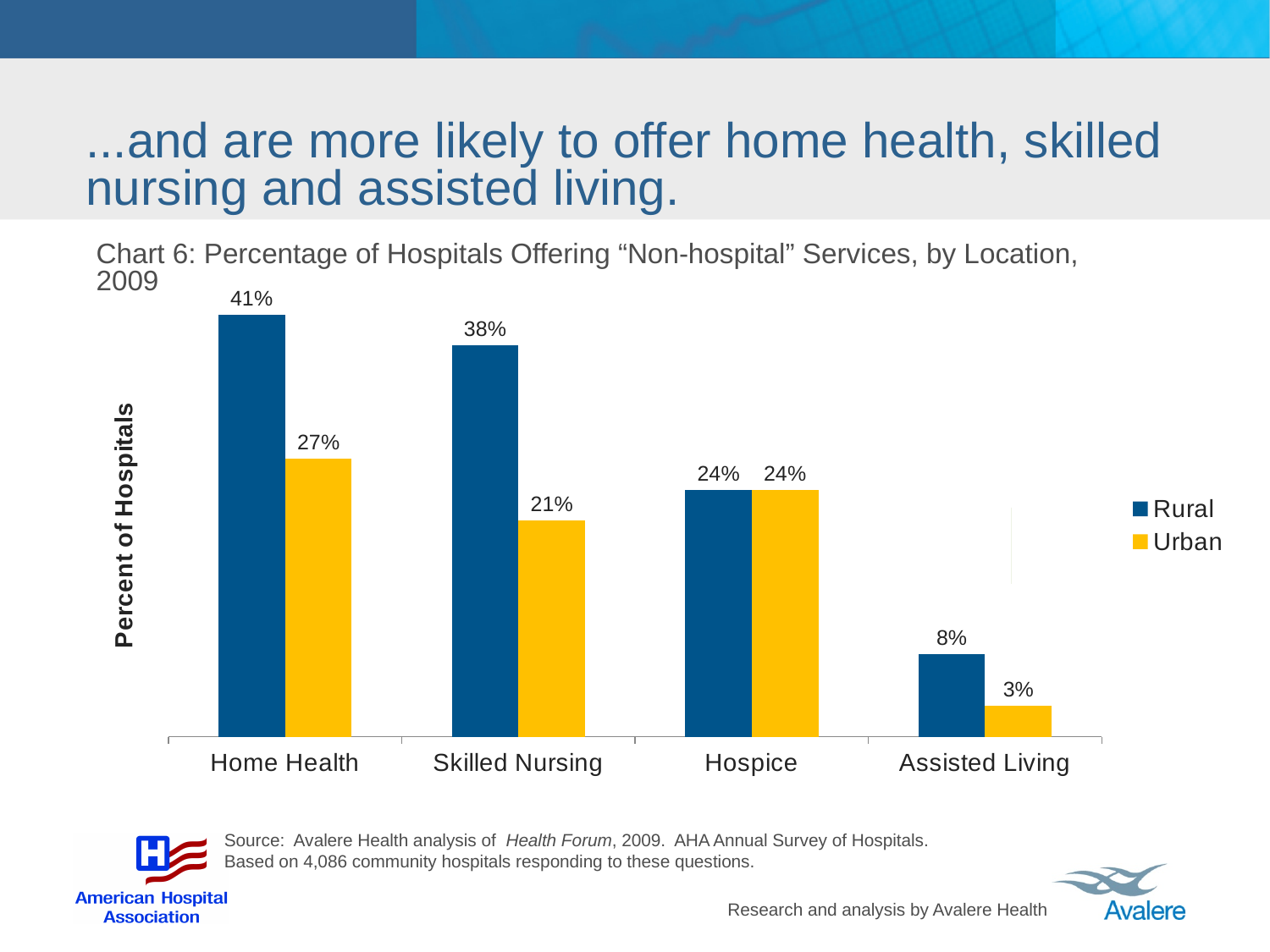
What percentage of urban hospitals offer skilled nursing services? 21% Which service category has the lowest value for urban hospitals? Assisted Living What kind of chart is shown on the slide? Bar chart What is the difference between the rural and urban percentages for home health? 14% What is the difference between the rural and urban percentages for skilled nursing? 17% What percentage of rural hospitals offer home health services? 41% What is the label on the vertical axis of the chart? Percent of Hospitals How many service categories are shown on the x axis? 4 What percentage of urban hospitals offer assisted living services? 3% Which is larger, the rural or urban percentage for assisted living? Rural How many series does the legend list? 2 Which service category has the highest value for rural hospitals? Home Health